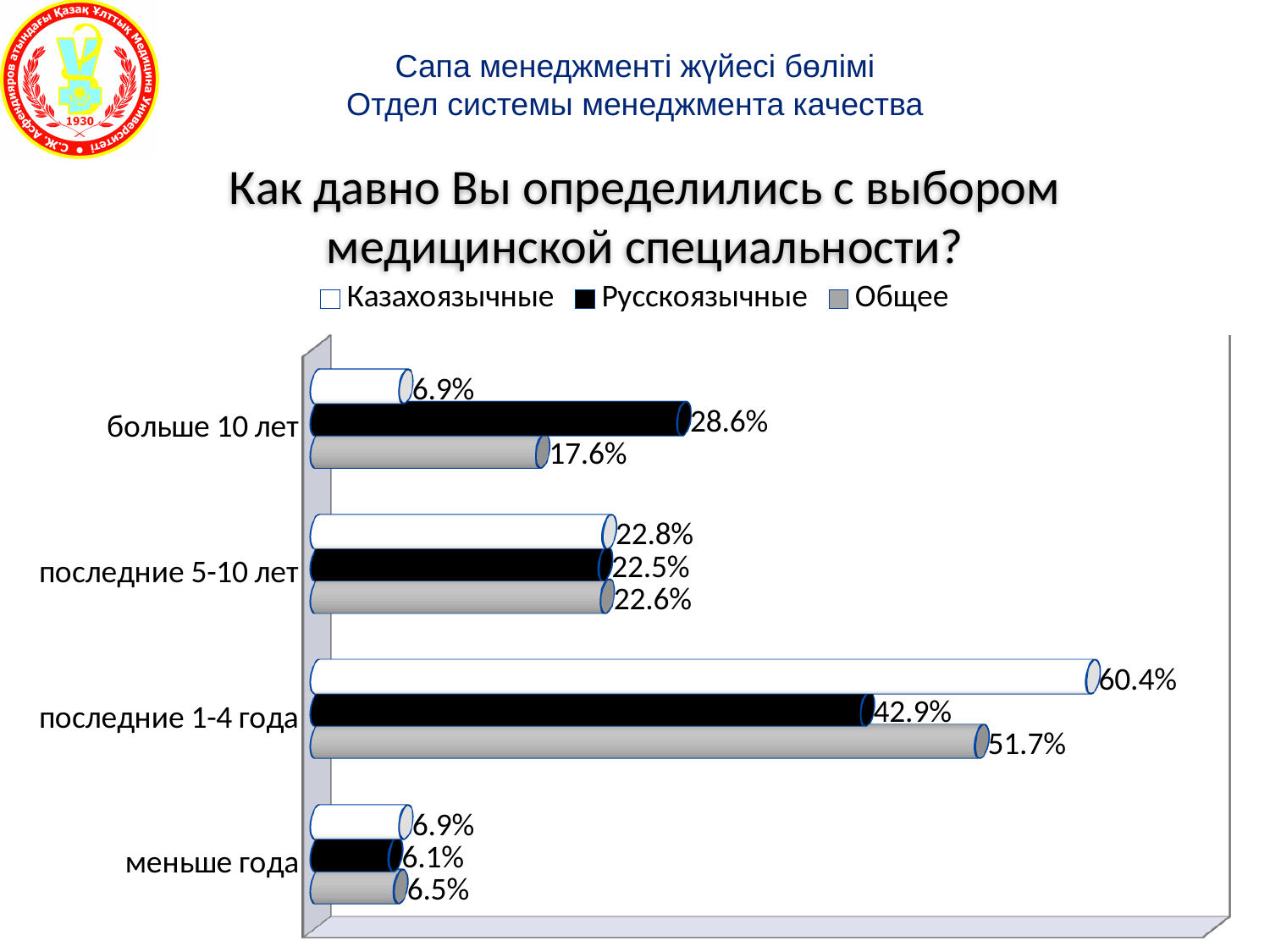
Which category has the lowest value for the Русскоязычные series? меньше года How many categories are shown on the chart? 4 Which category has the highest value for the Общее series? последние 1-4 года What is the value for Общее in the category 'последние 5-10 лет'? 22.6% What is the difference between the Казахоязычные and Русскоязычные values in the category 'последние 1-4 года'? 17.5% What is the value for Русскоязычные in the category 'больше 10 лет'? 28.6% How many series does the legend list? 3 What is the value for Казахоязычные in the category 'последние 1-4 года'? 60.4% Which series is shown in black on the chart? Русскоязычные In the category 'больше 10 лет', which series has the larger value: Казахоязычные or Общее? Общее What is the difference between the Русскоязычные and Казахоязычные values in the category 'больше 10 лет'? 21.7% What kind of chart is shown on the slide? bar chart